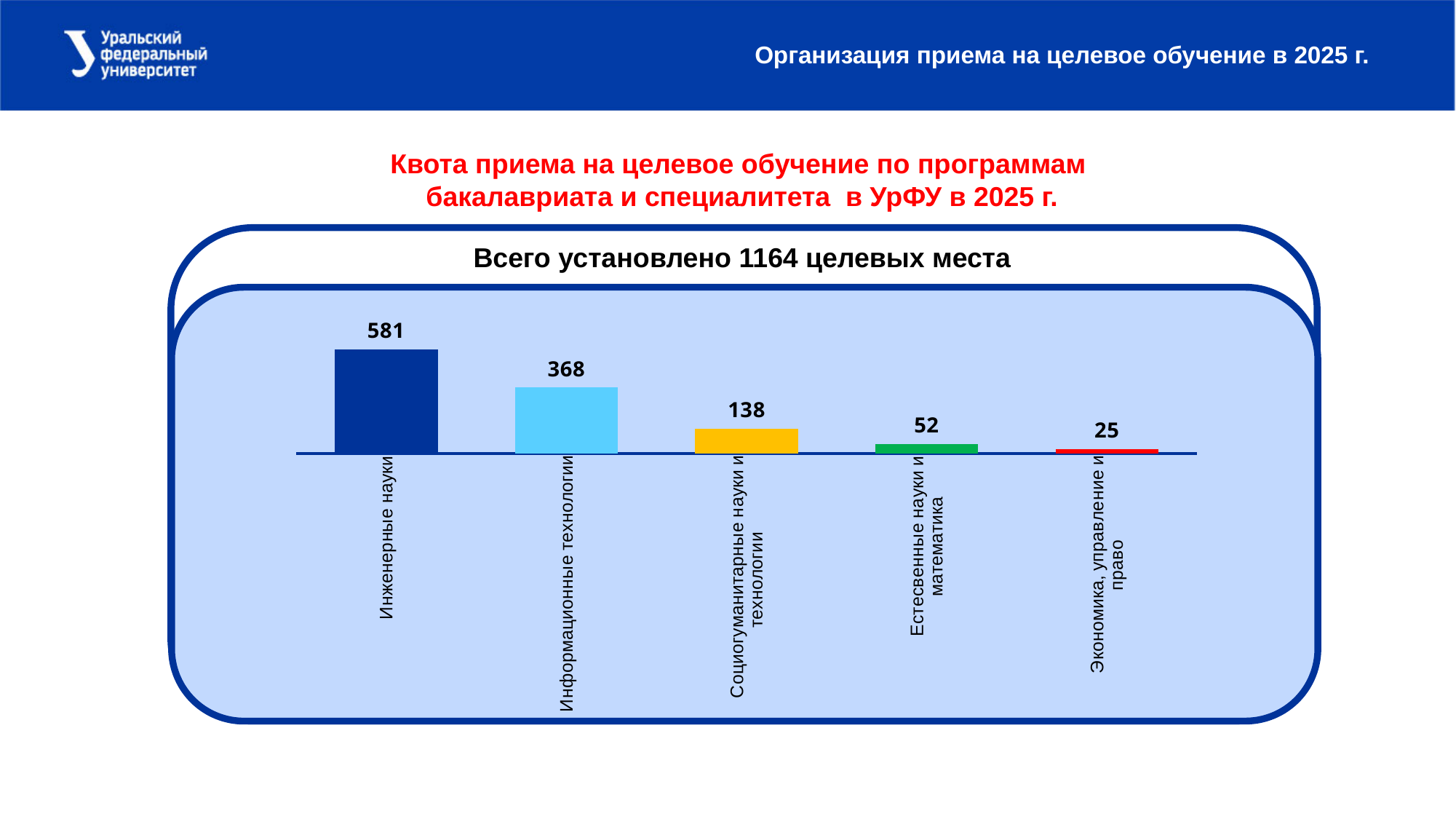
What is the value for Инженерные науки? 581 What is the value for Информационные технологии? 368 Which category has the highest value? Инженерные науки What is the value for Естественные науки и математика? 52 What kind of chart is shown on the slide? Bar chart Which category has the lowest value? Экономика, управление и право Do the values rise or fall from left to right across the categories? Fall What is the value for Социогуманитарные науки и технологии? 138 How many categories are shown in the chart? 5 What is the difference between the values for Инженерные науки and Информационные технологии? 213 What is the value for Экономика, управление и право? 25 Which is larger: the value for Социогуманитарные науки и технологии or the value for Естественные науки и математика? Социогуманитарные науки и технологии